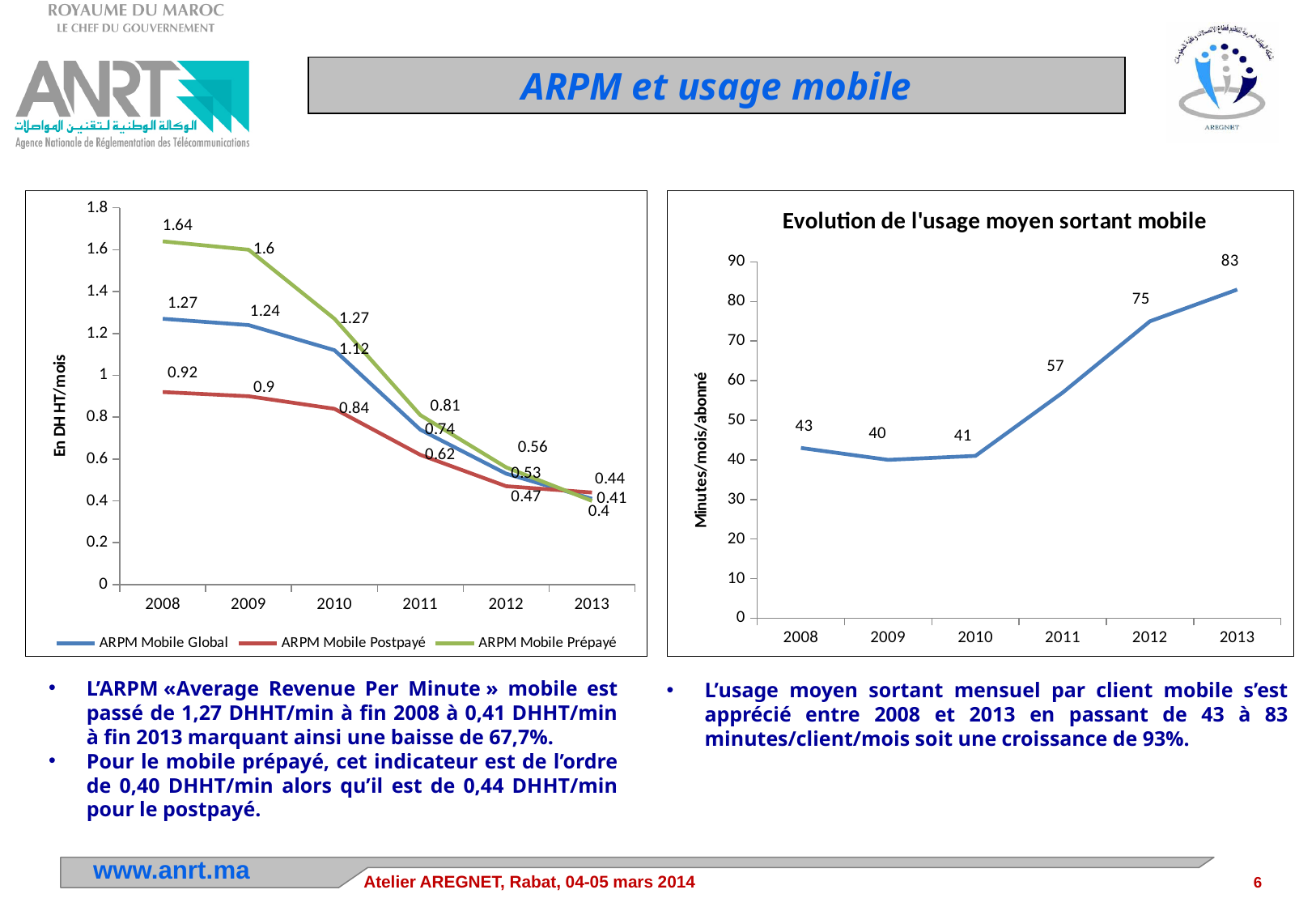
In the left-hand chart, what is the value of ARPM Mobile Prépayé in 2008? 1.64 In the left-hand chart, what is the difference between ARPM Mobile Global in 2008 and in 2013? 0.86 In the left-hand chart, how many series does the legend list? 3 In the left-hand chart, which series has the highest value in 2010? ARPM Mobile Prépayé In the right-hand chart 'Evolution de l'usage moyen sortant mobile', do the values rise or fall between 2010 and 2013? rise In the right-hand chart 'Evolution de l'usage moyen sortant mobile', which year has the lowest value? 2009 In the right-hand chart 'Evolution de l'usage moyen sortant mobile', what is the difference between the 2013 and 2008 values? 40 In the left-hand chart, which is larger in 2013: ARPM Mobile Postpayé or ARPM Mobile Prépayé? ARPM Mobile Postpayé What type of chart is the right-hand chart 'Evolution de l'usage moyen sortant mobile'? line chart In the right-hand chart 'Evolution de l'usage moyen sortant mobile', what is the value for 2013? 83 In the right-hand chart 'Evolution de l'usage moyen sortant mobile', how many years are plotted on the x axis? 6 In the left-hand chart, what is the value of ARPM Mobile Postpayé in 2011? 0.62